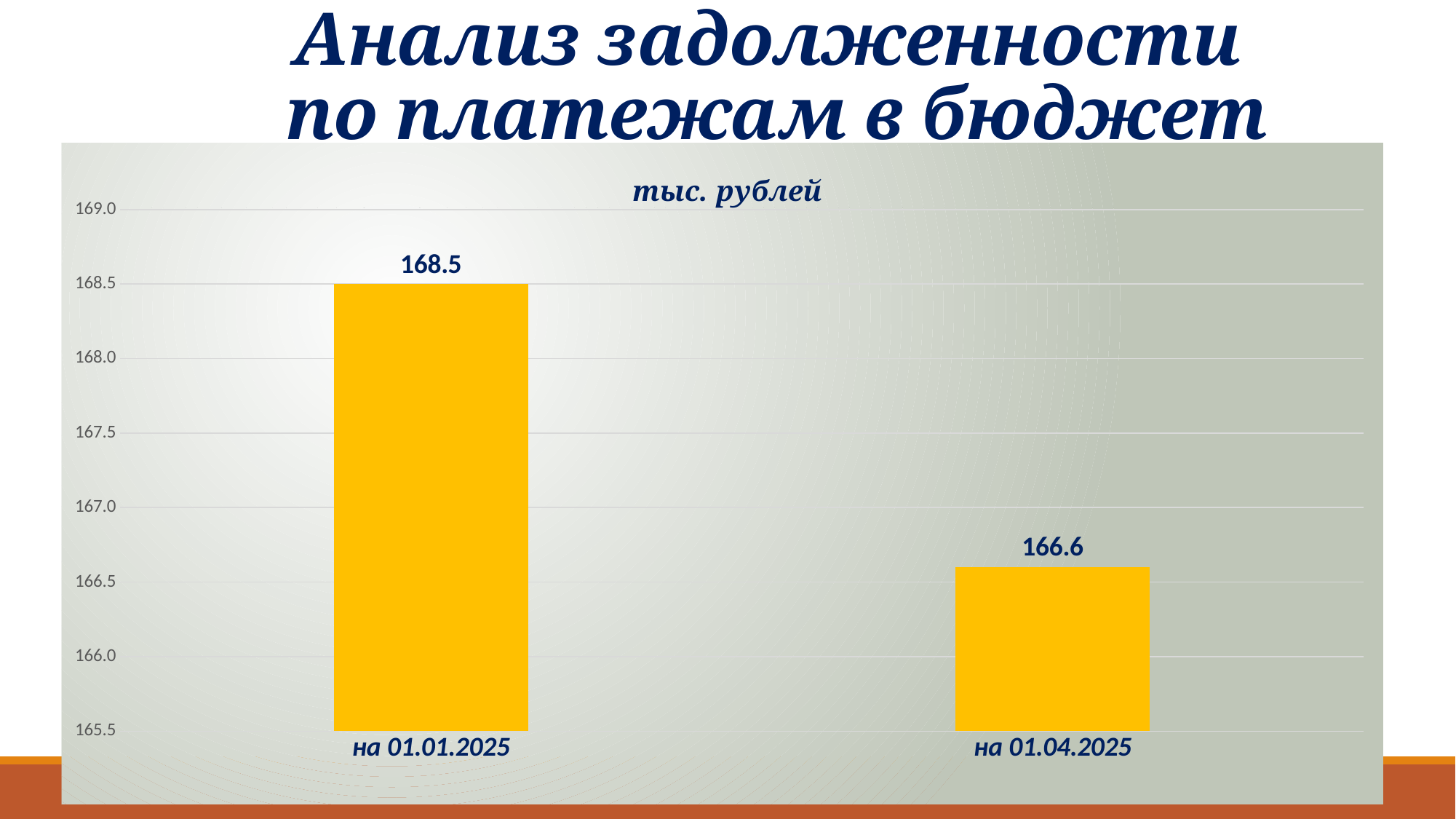
Which category has the lowest value? на 01.04.2025 What is the value for на 01.01.2025? 168.5 What kind of chart is shown on the slide? bar chart Which category has the highest value? на 01.01.2025 Do the values rise or fall from на 01.01.2025 to на 01.04.2025? fall What unit is given in the chart title? тыс. рублей What is the value for на 01.04.2025? 166.6 Is the value for на 01.01.2025 greater or less than 168.0? greater How many categories are shown in the chart? 2 Is the value for на 01.04.2025 greater or less than 167.0? less Which is larger, the value for на 01.01.2025 or the value for на 01.04.2025? на 01.01.2025 What is the difference between the values for на 01.01.2025 and на 01.04.2025? 1.9